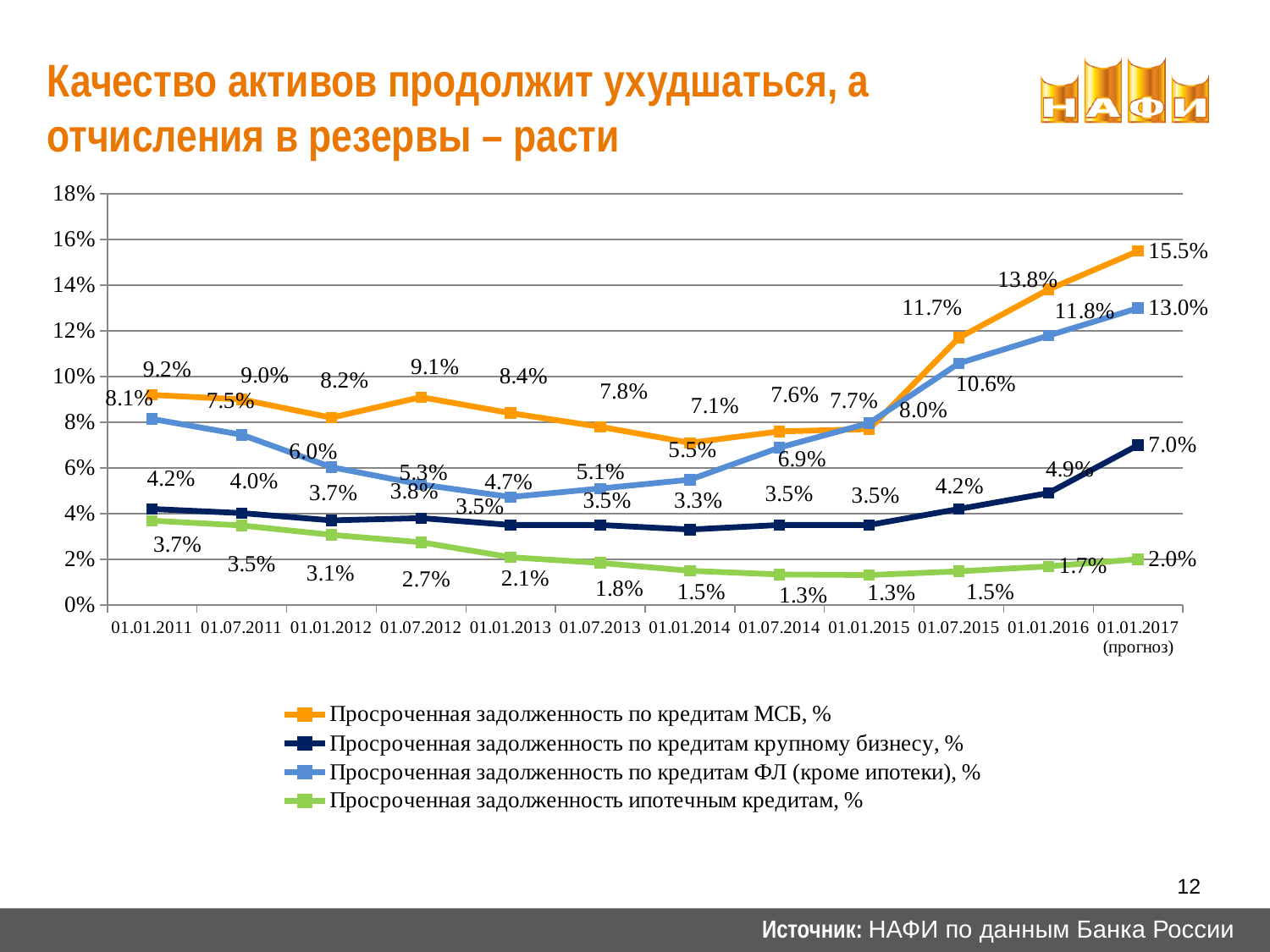
What is the lowest value shown for 'Просроченная задолженность ипотечным кредитам, %'? 1.3% How many dates are shown on the x axis? 12 How many series does the legend list? 4 At 01.01.2011, which is larger: 'Просроченная задолженность по кредитам МСБ, %' or 'Просроченная задолженность по кредитам ФЛ (кроме ипотеки), %'? Просроченная задолженность по кредитам МСБ, % What is the value of 'Просроченная задолженность ипотечным кредитам, %' at 01.01.2013? 2.1% What kind of chart is shown on the slide? Line chart At which date does 'Просроченная задолженность по кредитам МСБ, %' reach its highest value? 01.01.2017 (прогноз) What is the difference between 'Просроченная задолженность по кредитам МСБ, %' and 'Просроченная задолженность по кредитам ФЛ (кроме ипотеки), %' at 01.01.2017 (прогноз)? 2.5% What is the value of 'Просроченная задолженность по кредитам ФЛ (кроме ипотеки), %' at 01.07.2015? 10.6% What is the value of 'Просроченная задолженность по кредитам МСБ, %' at 01.01.2017 (прогноз)? 15.5% Does 'Просроченная задолженность по кредитам ФЛ (кроме ипотеки), %' rise or fall from 01.01.2014 to 01.01.2017 (прогноз)? Rise What is the value of 'Просроченная задолженность по кредитам крупному бизнесу, %' at 01.01.2016? 4.9%